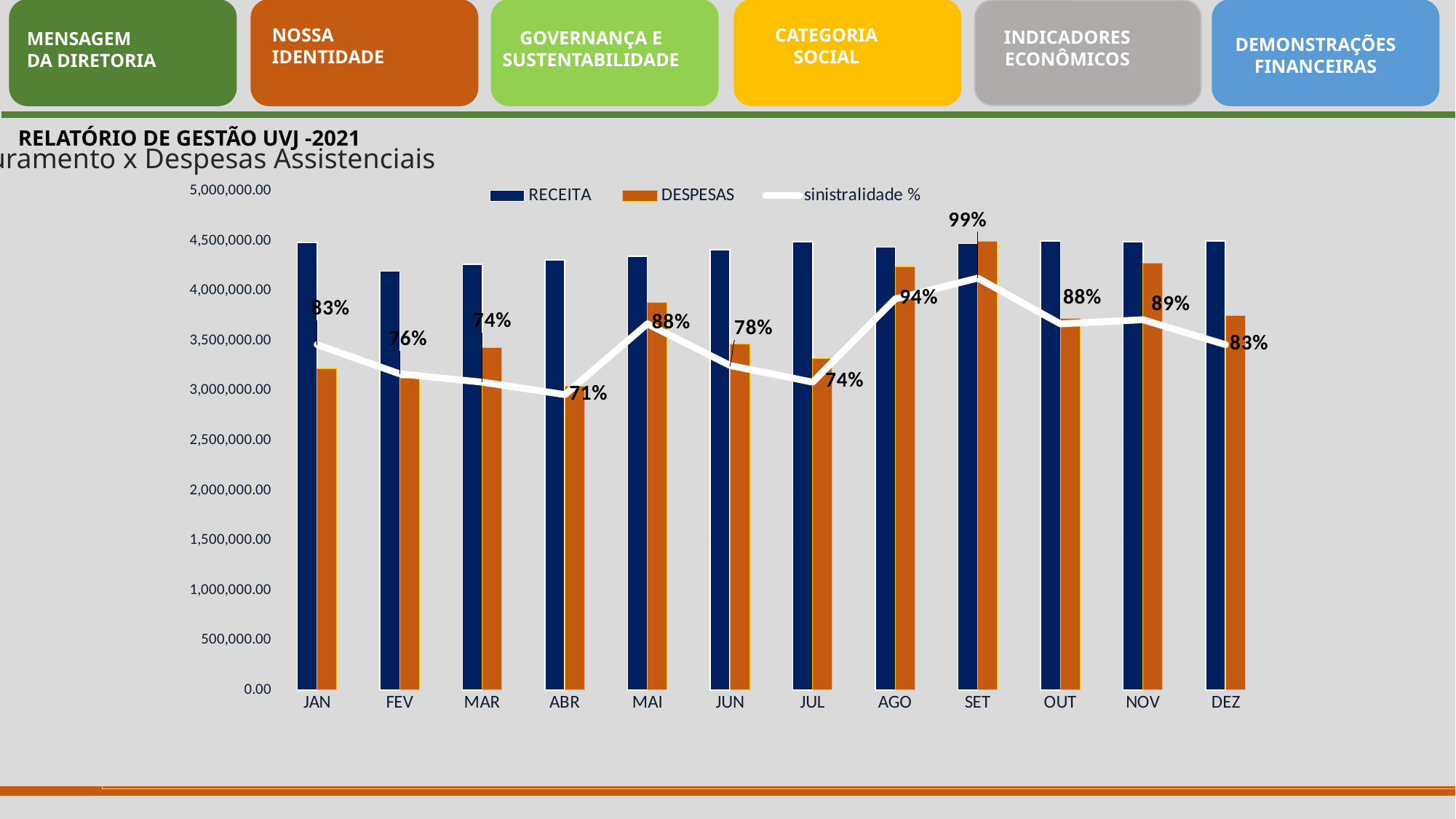
What is the sinistralidade % value for AGO? 94% What is the difference in sinistralidade % between SET and ABR? 28 percentage points What is the sinistralidade % value for ABR? 71% How many months are shown on the x axis? 12 Does the sinistralidade % rise or fall from JAN to ABR? fall Which month has the highest sinistralidade %? SET Which month has a higher sinistralidade %, MAI or AGO? AGO What is the sinistralidade % value for SET? 99% Is the RECEITA value for JAN greater or less than 4,000,000.00? greater Which month has the lowest sinistralidade %? ABR Is the DESPESAS value for MAI greater or less than 4,000,000.00? less How many series does the legend list? 3